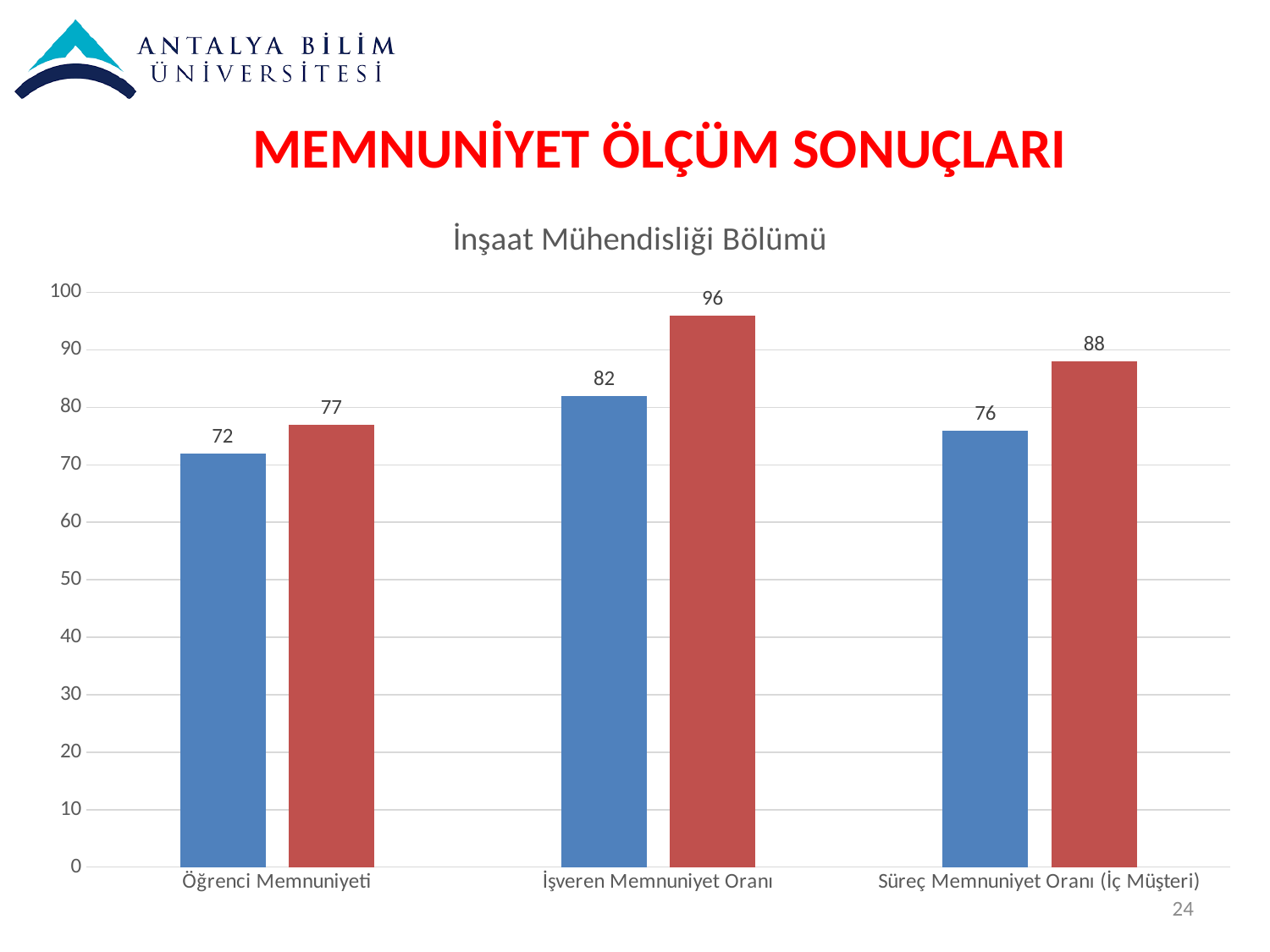
What is the difference between the red and blue bars for Öğrenci Memnuniyeti? 5 What is the title of the chart? İnşaat Mühendisliği Bölümü How many categories are shown on the x axis? 3 Which is larger: the blue bar for Süreç Memnuniyet Oranı (İç Müşteri) or the blue bar for İşveren Memnuniyet Oranı? İşveren Memnuniyet Oranı Which category has the highest red bar? İşveren Memnuniyet Oranı What is the value of the blue bar for İşveren Memnuniyet Oranı? 82 What type of chart is shown on the slide? Bar chart What is the difference between the red and blue bars for İşveren Memnuniyet Oranı? 14 What is the value of the blue bar for Öğrenci Memnuniyeti? 72 Which category has the lowest blue bar? Öğrenci Memnuniyeti What is the value of the red bar for Süreç Memnuniyet Oranı (İç Müşteri)? 88 What is the value of the red bar for İşveren Memnuniyet Oranı? 96